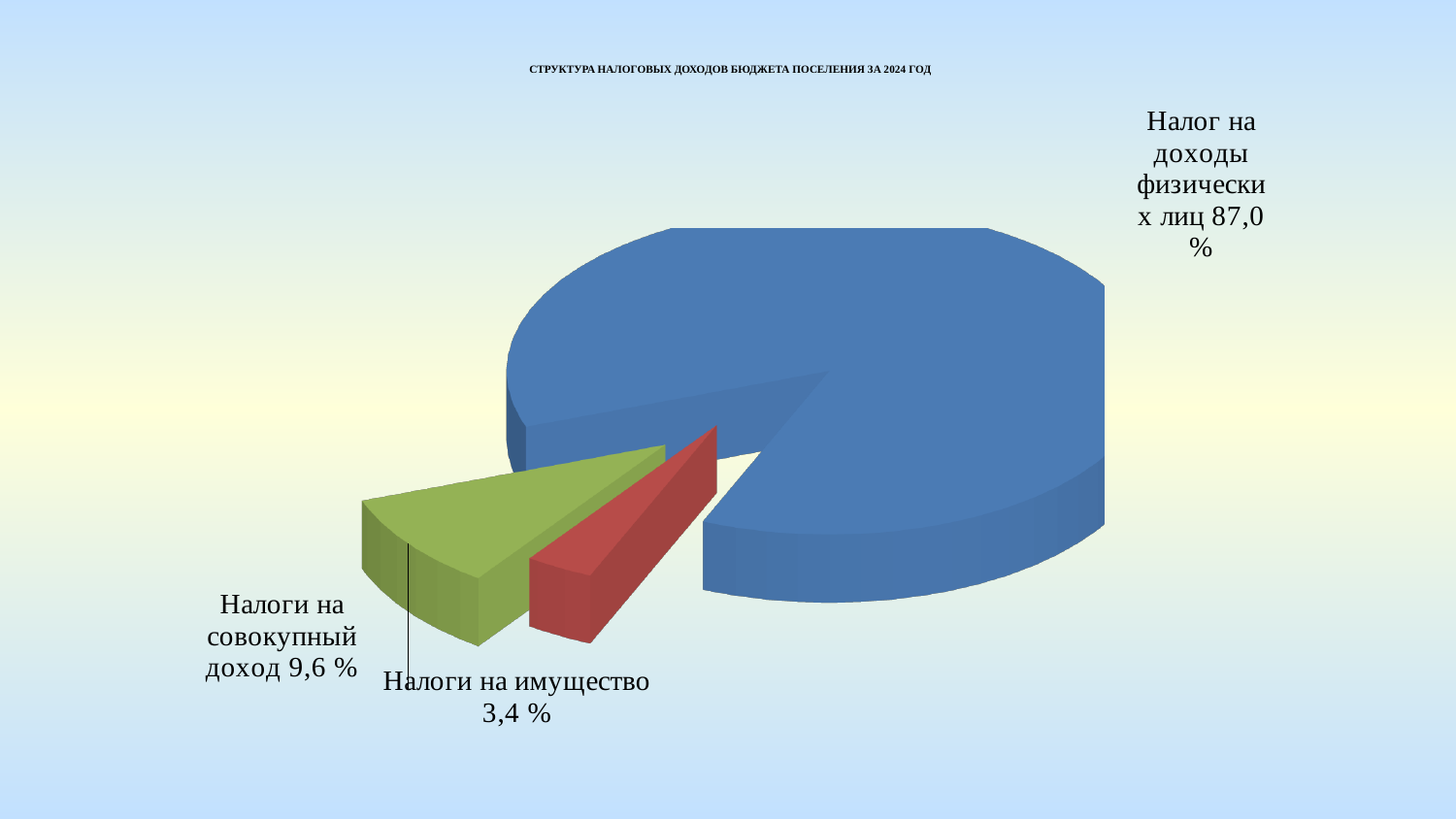
How many slices does the pie chart have? 3 What type of chart is shown on the slide? Pie chart Which category has the smallest slice of the pie? Налоги на имущество What share of the pie does Налог на доходы физических лиц have? 87,0 % What share of the pie does Налоги на имущество have? 3,4 % What is the difference in percentage points between Налоги на совокупный доход and Налоги на имущество? 6,2 Which category has the largest slice of the pie? Налог на доходы физических лиц What colour is the largest slice of the pie? Blue Which is larger: the share of Налоги на совокупный доход or the share of Налоги на имущество? Налоги на совокупный доход What share of the pie does Налоги на совокупный доход have? 9,6 % What is the title of the chart? СТРУКТУРА НАЛОГОВЫХ ДОХОДОВ БЮДЖЕТА ПОСЕЛЕНИЯ ЗА 2024 ГОД What is the difference in percentage points between Налог на доходы физических лиц and Налоги на совокупный доход? 77,4